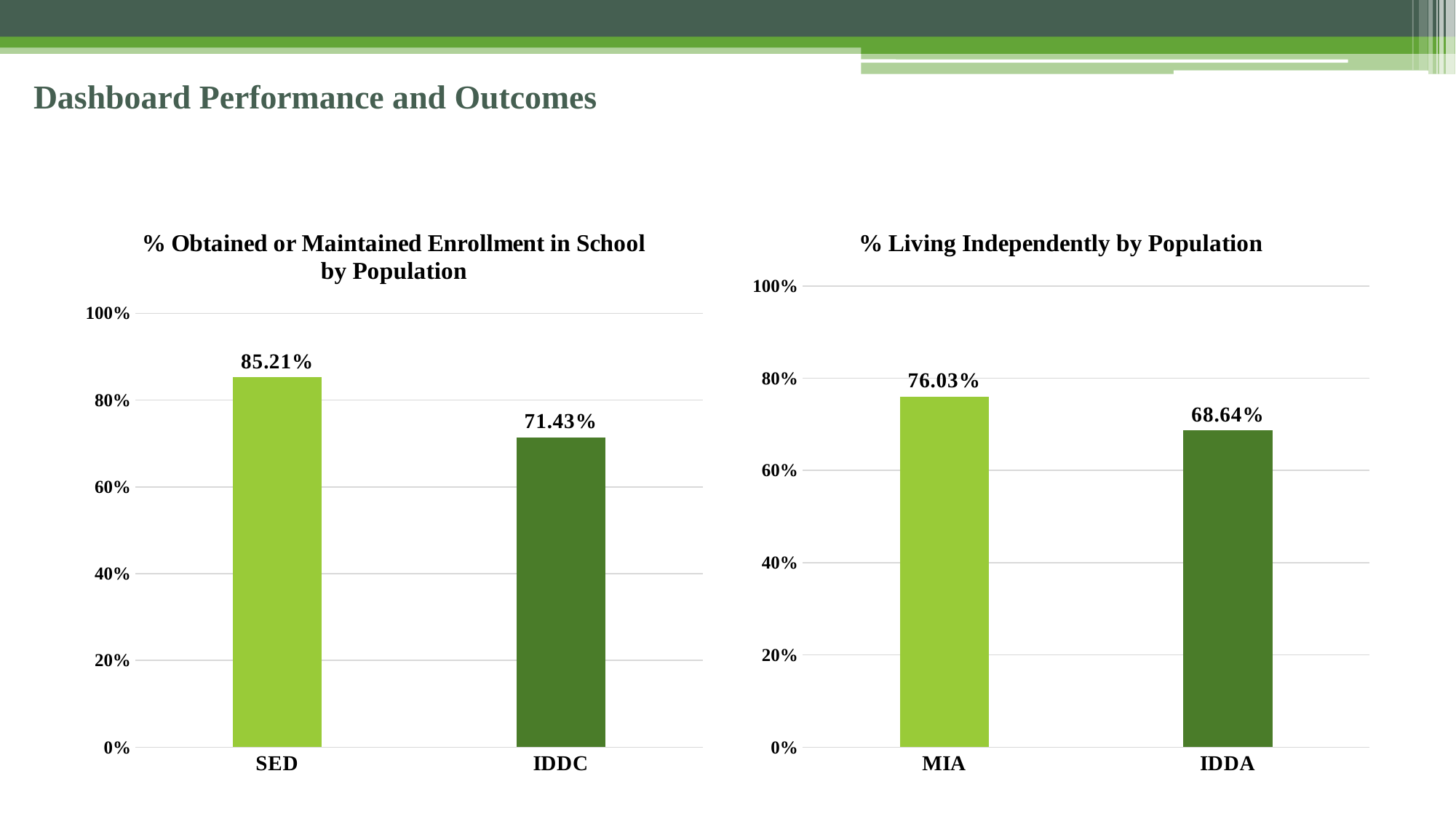
What kind of chart is the '% Living Independently by Population' chart? bar chart In the '% Living Independently by Population' chart, what is the value for MIA? 76.03% What is the title of the chart on the right side of the slide? % Living Independently by Population In the '% Obtained or Maintained Enrollment in School by Population' chart, what is the difference between the SED and IDDC values? 13.78% In the '% Obtained or Maintained Enrollment in School by Population' chart, which population has the highest value? SED In the '% Obtained or Maintained Enrollment in School by Population' chart, what is the value for IDDC? 71.43% In the '% Living Independently by Population' chart, what is the value for IDDA? 68.64% How many categories are shown in the '% Obtained or Maintained Enrollment in School by Population' chart? 2 In the '% Living Independently by Population' chart, is the value for MIA greater or less than 80%? less In the '% Obtained or Maintained Enrollment in School by Population' chart, what is the value for SED? 85.21% In the '% Living Independently by Population' chart, which population has the lowest value? IDDA In the '% Living Independently by Population' chart, what is the difference between the MIA and IDDA values? 7.39%